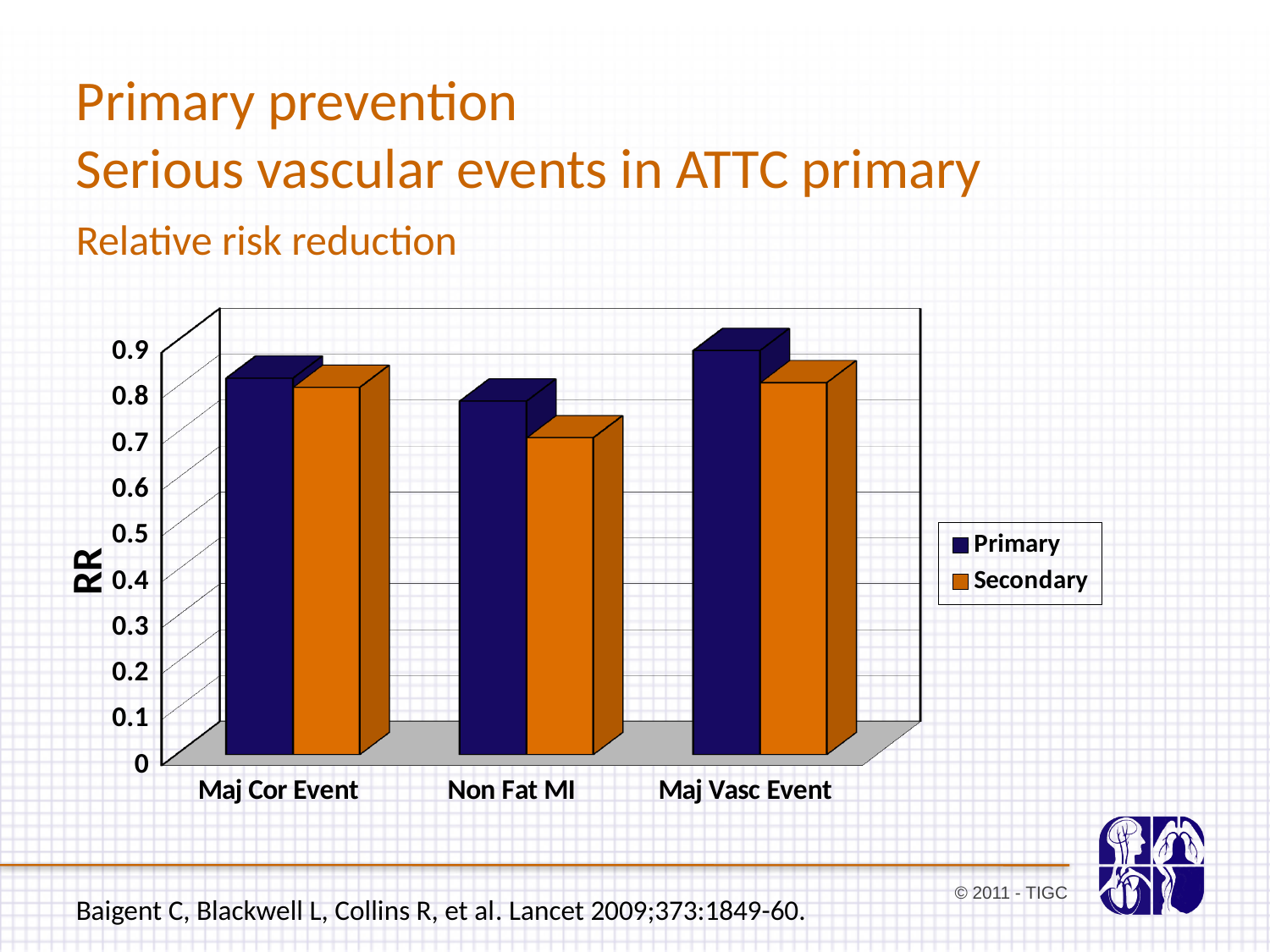
Which category has the lowest value for the Primary series? Non Fat MI What kind of chart is shown on the slide? Bar chart How many series does the chart's legend list? 2 For Non Fat MI, which series has the larger value, Primary or Secondary? Primary For Maj Vasc Event, which series has the larger value, Primary or Secondary? Primary Is the Secondary value for Non Fat MI greater or less than 0.8? less Which category has the highest value for the Primary series? Maj Vasc Event What is the label on the vertical axis of the chart? RR Is the Primary value for Maj Vasc Event greater or less than 0.8? greater How many categories are shown on the x axis of the chart? 3 Which category has the lowest value for the Secondary series? Non Fat MI Is the Primary value for Maj Cor Event greater or less than 0.7? greater